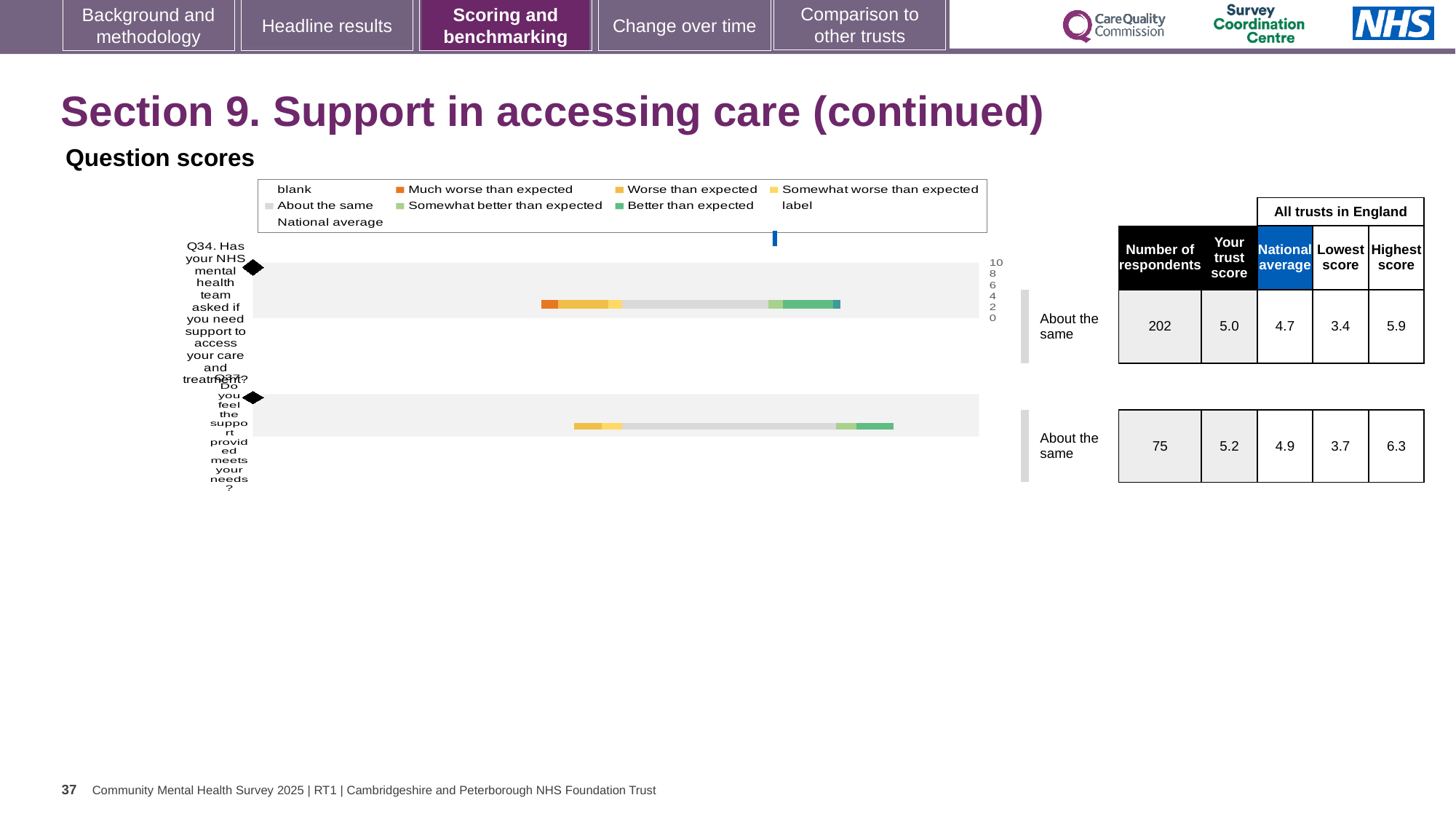
How many questions (bars) are plotted in the question scores chart? 2 What benchmark category is shown for Q34 next to the chart? About the same How many respondents are listed for Q34 in the table beside the chart? 202 Which question has more respondents, Q34 or Q37? Q34 What is the highest value shown on the chart's score axis? 10 By how much does the trust score for Q37 exceed the national average for Q37? 0.3 What is the highest score among all trusts in England for Q37? 6.3 What is the difference between the highest score and the lowest score for Q34? 2.5 What is the national average for Q34 in the table beside the chart? 4.7 Which colour in the legend represents 'Much worse than expected'? orange What kind of chart is used to show the question scores on this slide? bar chart What is the trust score for Q37 in the table beside the chart? 5.2